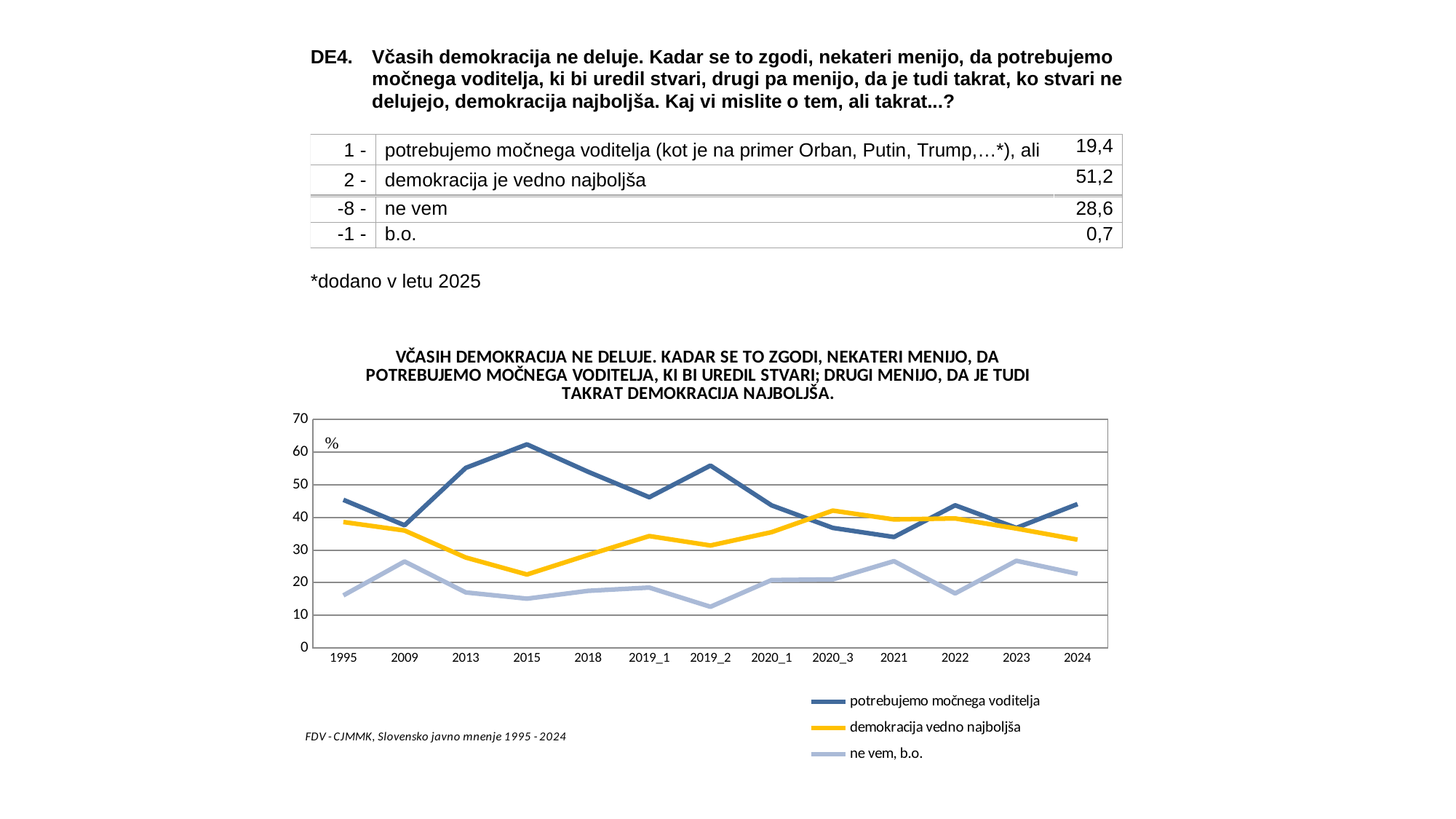
In 1995, which series has the higher value: 'potrebujemo močnega voditelja' or 'demokracija vedno najboljša'? potrebujemo močnega voditelja What colour is the line for 'demokracija vedno najboljša' in the chart? yellow In which year does the series 'potrebujemo močnega voditelja' reach its highest value? 2015 Does the series 'demokracija vedno najboljša' rise or fall from 1995 to 2015? fall Is the value for 'potrebujemo močnega voditelja' in 2019_2 greater or less than 50? greater Is the value for 'ne vem, b.o.' in 2019_2 greater or less than 20? less How many series does the chart legend list? 3 Is the value for 'demokracija vedno najboljša' in 2015 greater or less than 30? less What kind of chart is shown on the slide? line chart In which year does the series 'ne vem, b.o.' reach its lowest value? 2019_2 How many time points are shown along the x axis of the chart? 13 In which year does the series 'demokracija vedno najboljša' reach its lowest value? 2015